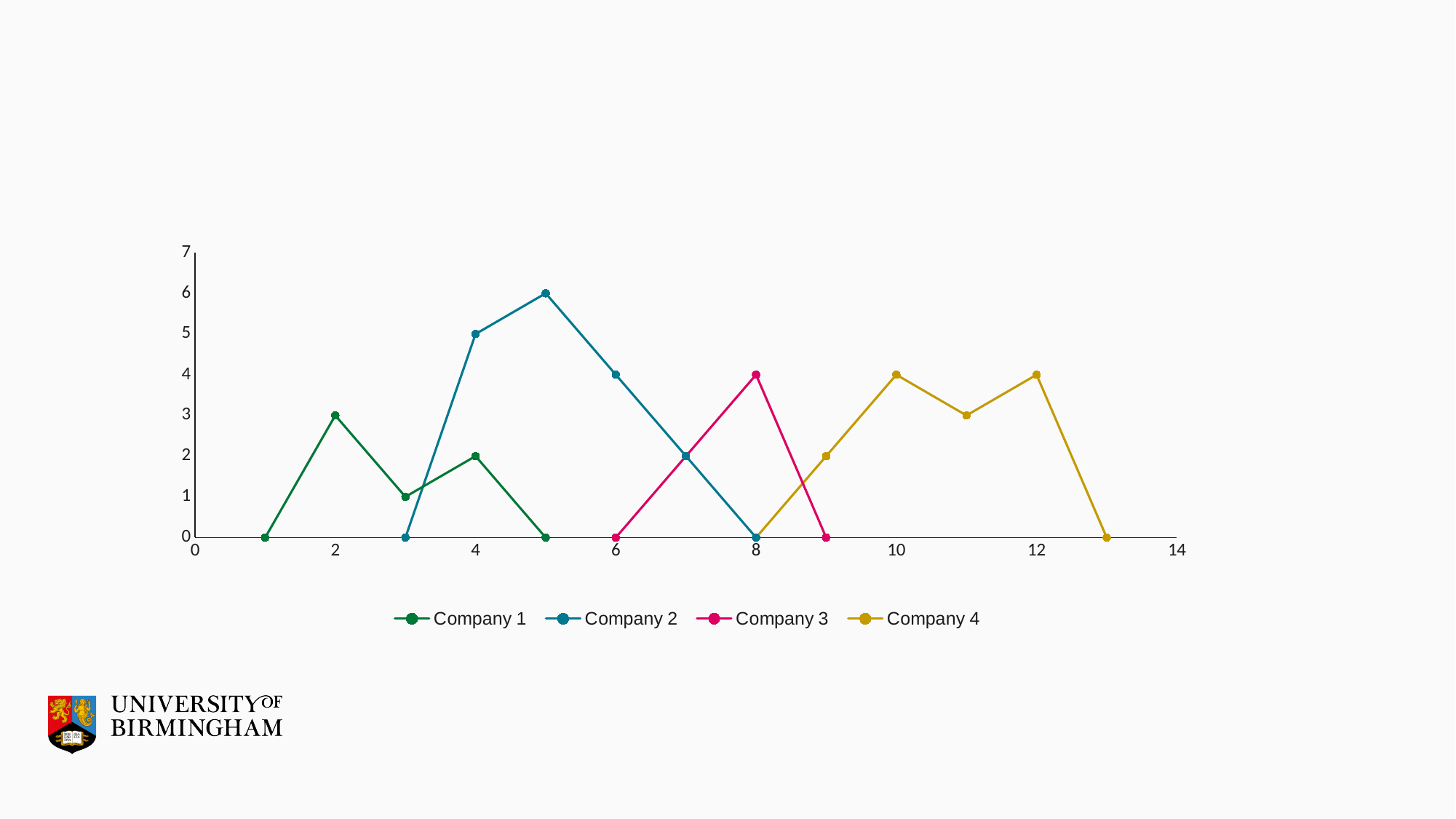
What is the value for Company 1 at x = 2? 3 How many series does the legend list? 4 How many data points are plotted for Company 1? 5 What is the value for Company 2 at x = 4? 5 What kind of chart is shown on the slide? line chart What is the value for Company 3 at x = 8? 4 What is the difference between the value for Company 2 and the value for Company 1 at x = 4? 3 What is the value for Company 2 at x = 6? 4 What is the value for Company 4 at x = 10? 4 Is the highest value for Company 2 greater or less than 5? greater At x = 8, which is larger: the value for Company 3 or the value for Company 2? Company 3 Which series reaches the highest value on the chart? Company 2